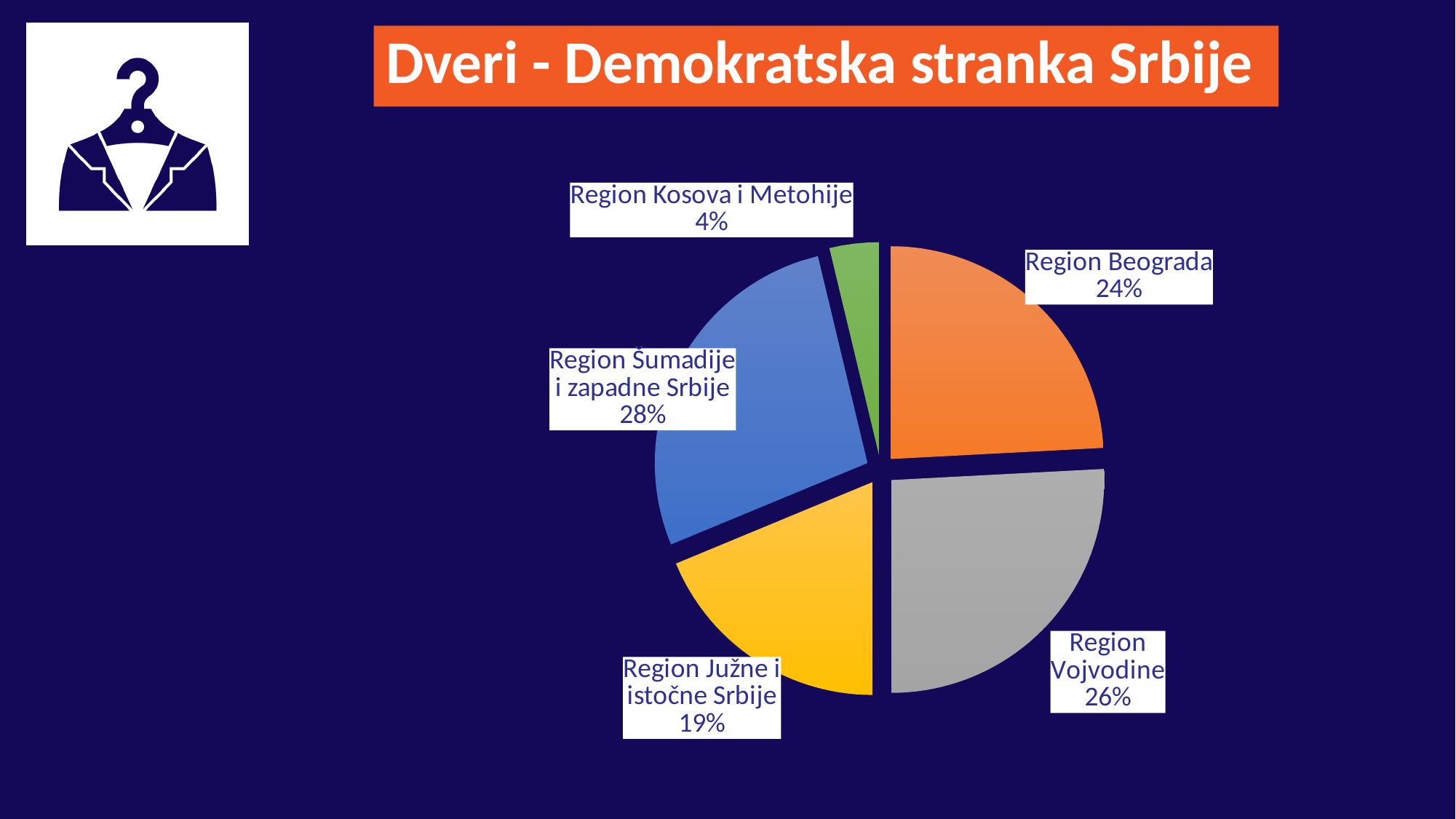
What share of the pie does Region Južne i istočne Srbije have? 19% What share of the pie does Region Beograda have? 24% What kind of chart is shown on the slide? Pie chart What share of the pie does Region Vojvodine have? 26% Which region has the largest slice of the pie? Region Šumadije i zapadne Srbije Which is larger, the share for Region Vojvodine or the share for Region Beograda? Region Vojvodine What is the difference in percentage points between Region Šumadije i zapadne Srbije and Region Južne i istočne Srbije? 9 How many regions are shown in the pie chart? 5 What colour is the slice for Region Vojvodine? Grey What is the title shown above the chart? Dveri - Demokratska stranka Srbije What share of the pie does Region Kosova i Metohije have? 4% Which region has the smallest slice of the pie? Region Kosova i Metohije